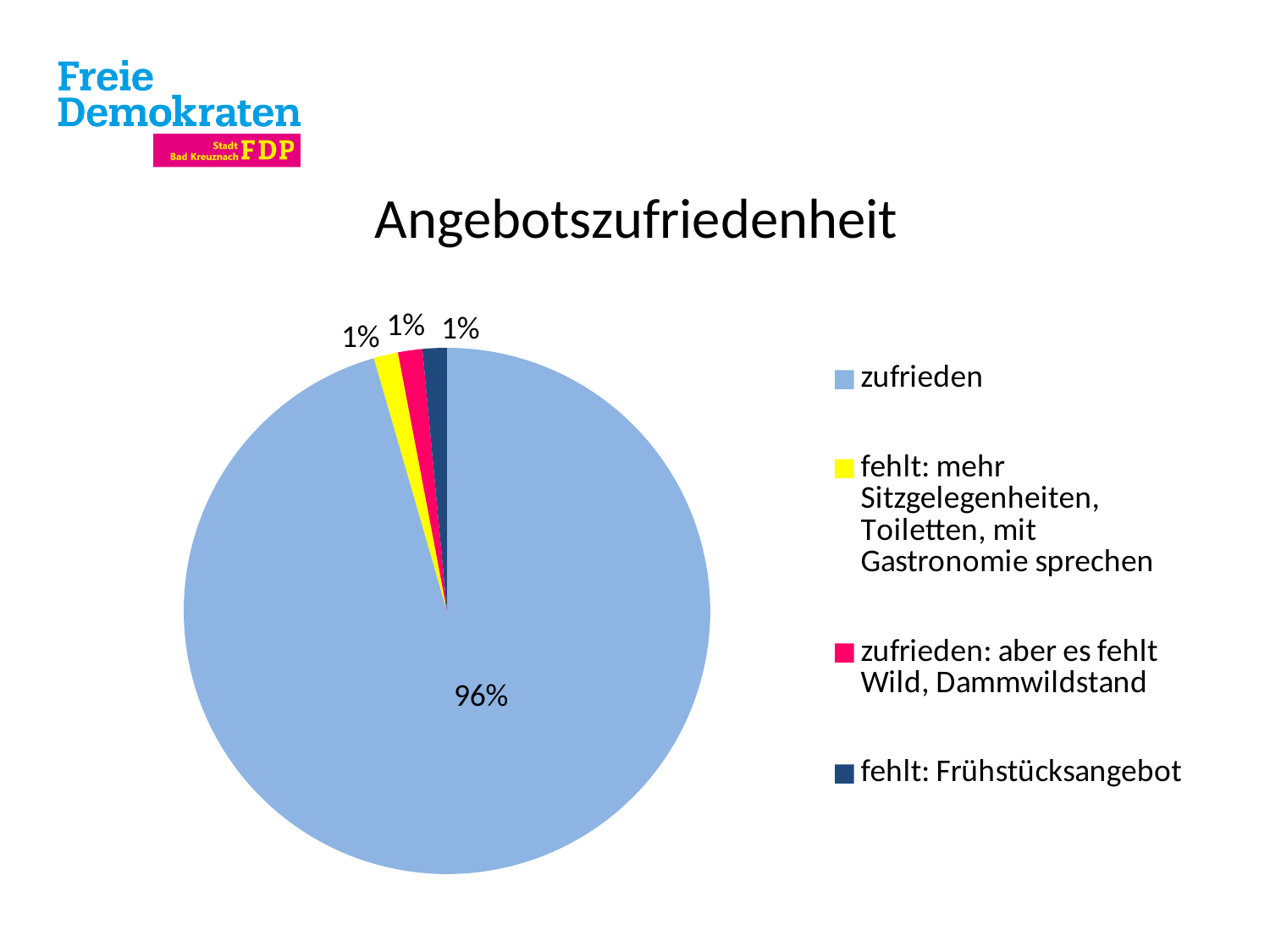
What share of the pie is labelled "zufrieden"? 96% What is the difference in percentage points between the "zufrieden" slice and the "fehlt: Frühstücksangebot" slice? 95 How many slices does the pie chart have? 4 How many entries does the legend list? 4 What is the title of the chart? Angebotszufriedenheit Which is larger, the slice for "zufrieden" or the slice for "fehlt: Frühstücksangebot"? zufrieden What is the value shown for "zufrieden: aber es fehlt Wild, Dammwildstand"? 1% Which colour represents "zufrieden" in the legend? light blue What is the value shown for "fehlt: Frühstücksangebot"? 1% Which category has the largest slice of the pie? zufrieden What is the value shown for "fehlt: mehr Sitzgelegenheiten, Toiletten, mit Gastronomie sprechen"? 1% What kind of chart is shown on the slide? pie chart